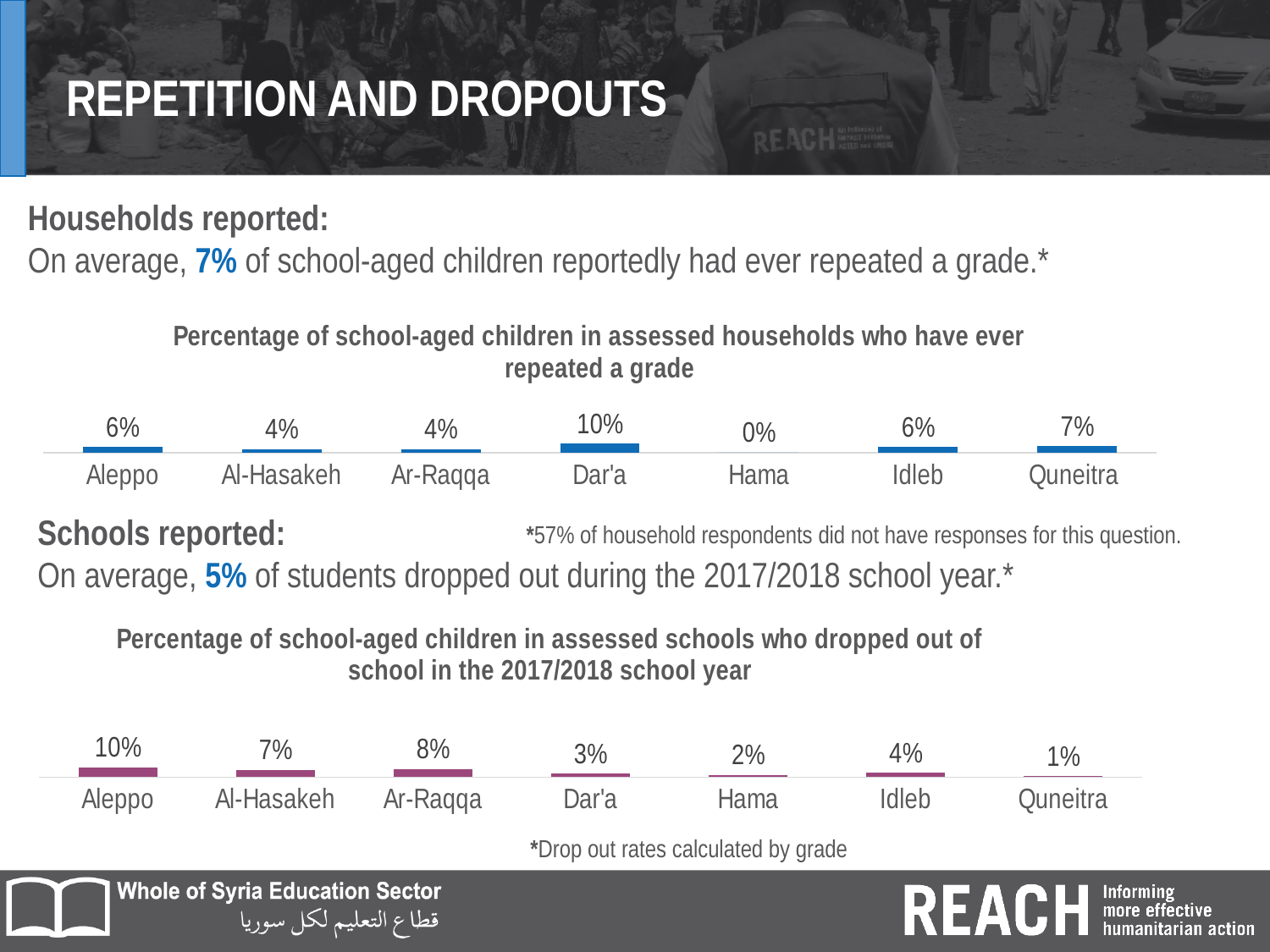
What type of chart is the bottom chart (children who dropped out in the 2017/2018 school year)? Bar chart In the top chart (children who have ever repeated a grade), what is the difference between Dar'a and Al-Hasakeh? 6% In the top chart (children who have ever repeated a grade), how many governorates are shown? 7 In the bottom chart (children who dropped out in the 2017/2018 school year), which governorate has the lowest value? Quneitra In the top chart (children who have ever repeated a grade), which governorate has the lowest value? Hama In the top chart (children who have ever repeated a grade), what is the value for Dar'a? 10% In the bottom chart (children who dropped out in the 2017/2018 school year), what is the value for Hama? 2% In the bottom chart (children who dropped out in the 2017/2018 school year), what is the value for Ar-Raqqa? 8% In the top chart (children who have ever repeated a grade), what is the value for Quneitra? 7% In the top chart (children who have ever repeated a grade), which governorate has the highest value? Dar'a In the bottom chart (children who dropped out in the 2017/2018 school year), which is larger, Al-Hasakeh or Idleb? Al-Hasakeh In the bottom chart (children who dropped out in the 2017/2018 school year), which governorate has the highest value? Aleppo